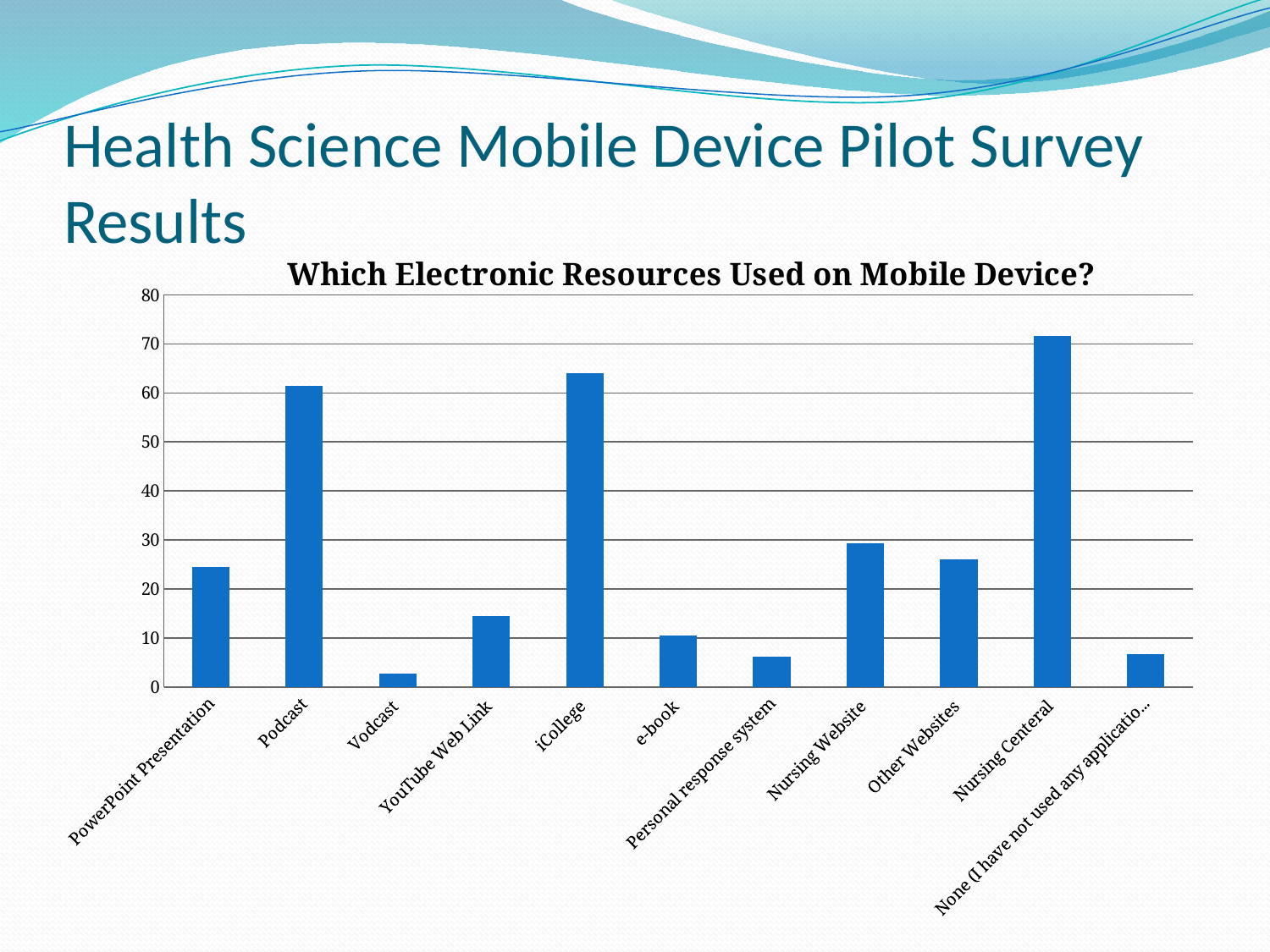
Which is larger, the value for PowerPoint Presentation or the value for YouTube Web Link? PowerPoint Presentation Is the value for YouTube Web Link greater or less than 10? greater Which is larger, the value for e-book or the value for Personal response system? e-book Which category has the highest value? Nursing Centeral Is the value for Podcast greater or less than 50? greater What is the title of the chart? Which Electronic Resources Used on Mobile Device? Is the value for Other Websites greater or less than 20? greater How many categories are shown on the x axis of the chart? 11 What kind of chart is shown on the slide? bar chart Which category has the lowest value? Vodcast